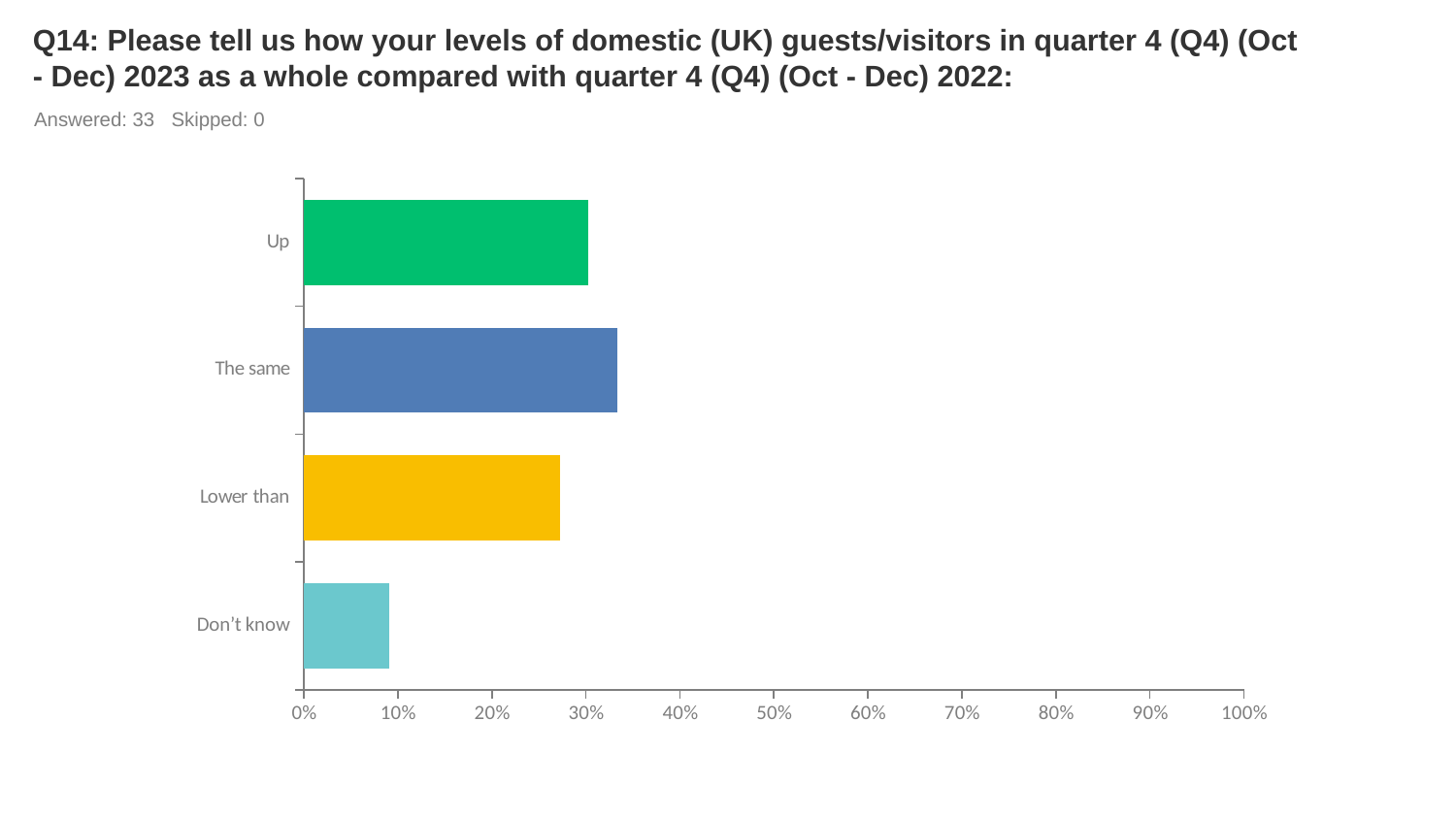
Is the value for Lower than greater or less than 30%? less Which is larger, the value for The same or the value for Don't know? The same Is the value for The same greater or less than 30%? greater Which category has the highest value? The same What kind of chart is shown on the slide? bar chart Is the value for Don't know greater or less than 20%? less Which category has the lowest value? Don't know Which is larger, the value for Up or the value for Lower than? Up What is the highest value shown on the x axis? 100% How many categories are shown on the chart? 4 How many respondents answered this question according to the slide? 33